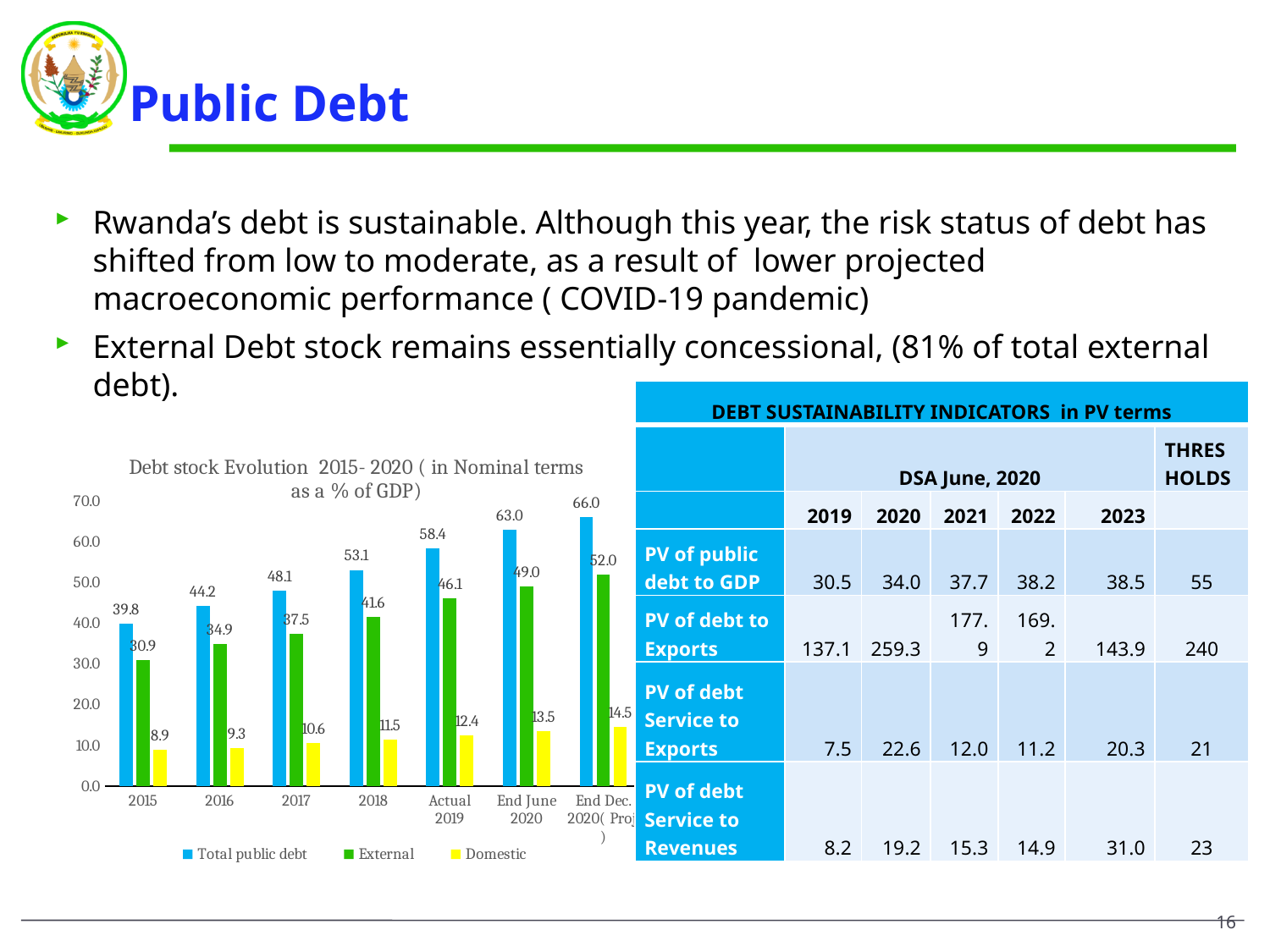
Which is larger: External debt in Actual 2019 or Total public debt in 2016? External debt in Actual 2019 How many series does the chart legend list? 3 Does Total public debt rise or fall from 2015 to End Dec. 2020 (Proj)? Rise What is the value of Total public debt in 2015? 39.8 What type of chart is shown on the slide? Bar chart Which category has the highest Total public debt value? End Dec. 2020 (Proj) Which category has the lowest Domestic debt value? 2015 What is the difference between Total public debt in 2018 and in 2017? 5.0 What is the title of the chart? Debt stock Evolution 2015-2020 (in Nominal terms as a % of GDP) What is the value of Domestic debt in 2018? 11.5 How many categories are shown on the x axis of the chart? 7 What is the value of External debt for End June 2020? 49.0